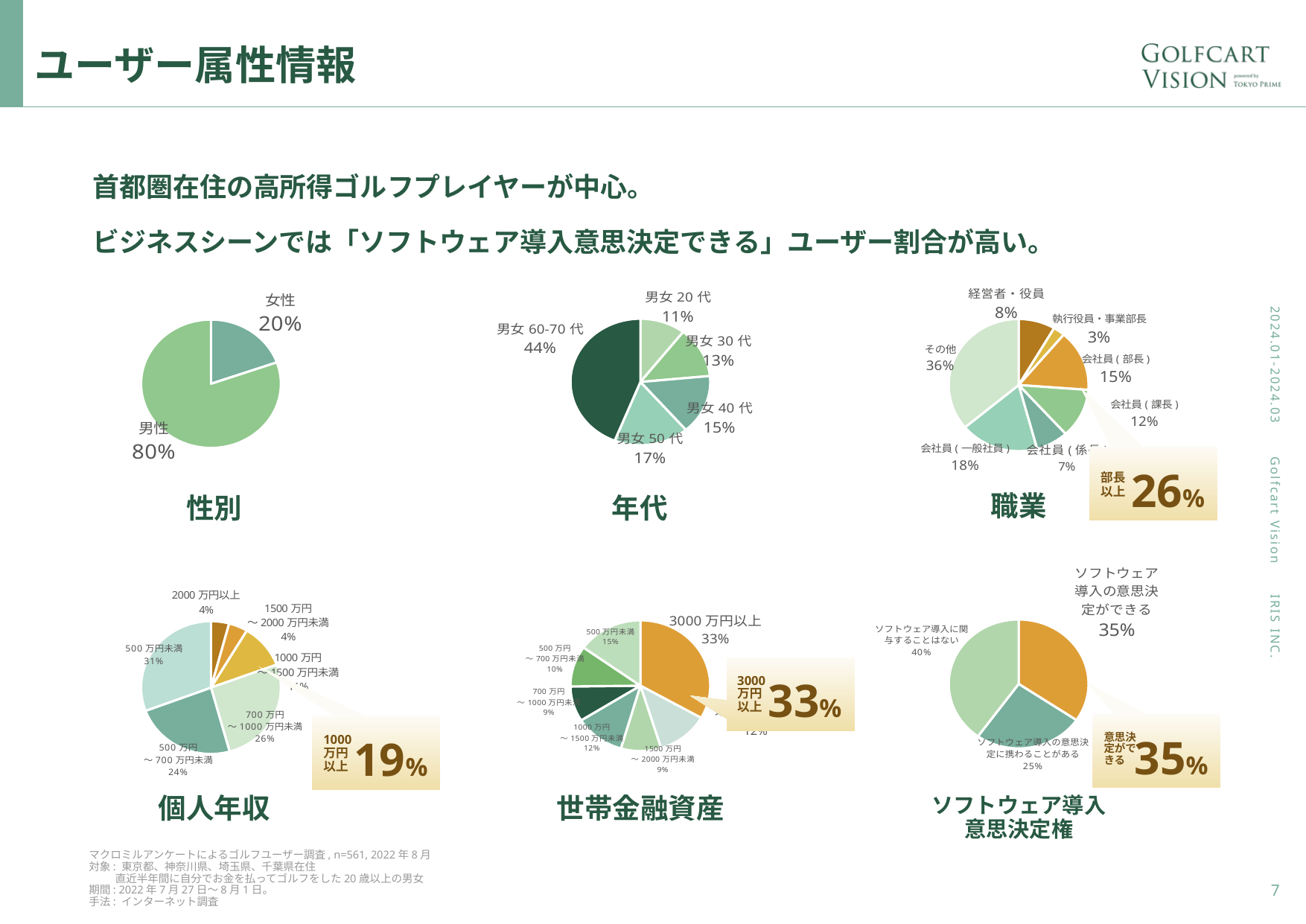
In the 職業 chart, what is the share for 会社員 ( 一般社員 )? 18% In the 世帯金融資産 chart, what is the share for 3000 万円以上? 33% In the 職業 chart, which is larger: 会社員 ( 部長 ) or 会社員 ( 課長 )? 会社員 ( 部長 ) In the 職業 chart, which category has the smallest share? 執行役員・事業部長 What kind of chart is used for 性別? Pie chart In the ソフトウェア導入意思決定権 chart, what is the share for ソフトウェア導入の意思決定に携わることがある? 25% In the 年代 chart, which age group has the largest share? 男女 60-70 代 In the ソフトウェア導入意思決定権 chart, which category has the largest share? ソフトウェア導入に関与することはない In the 年代 chart, what is the difference between the shares of 男女 60-70 代 and 男女 20 代? 33% In the 個人年収 chart, what is the share for 500 万円未満? 31% In the 性別 chart, what percentage is 男性? 80% In the 年代 chart, what is the share for 男女 40 代? 15%